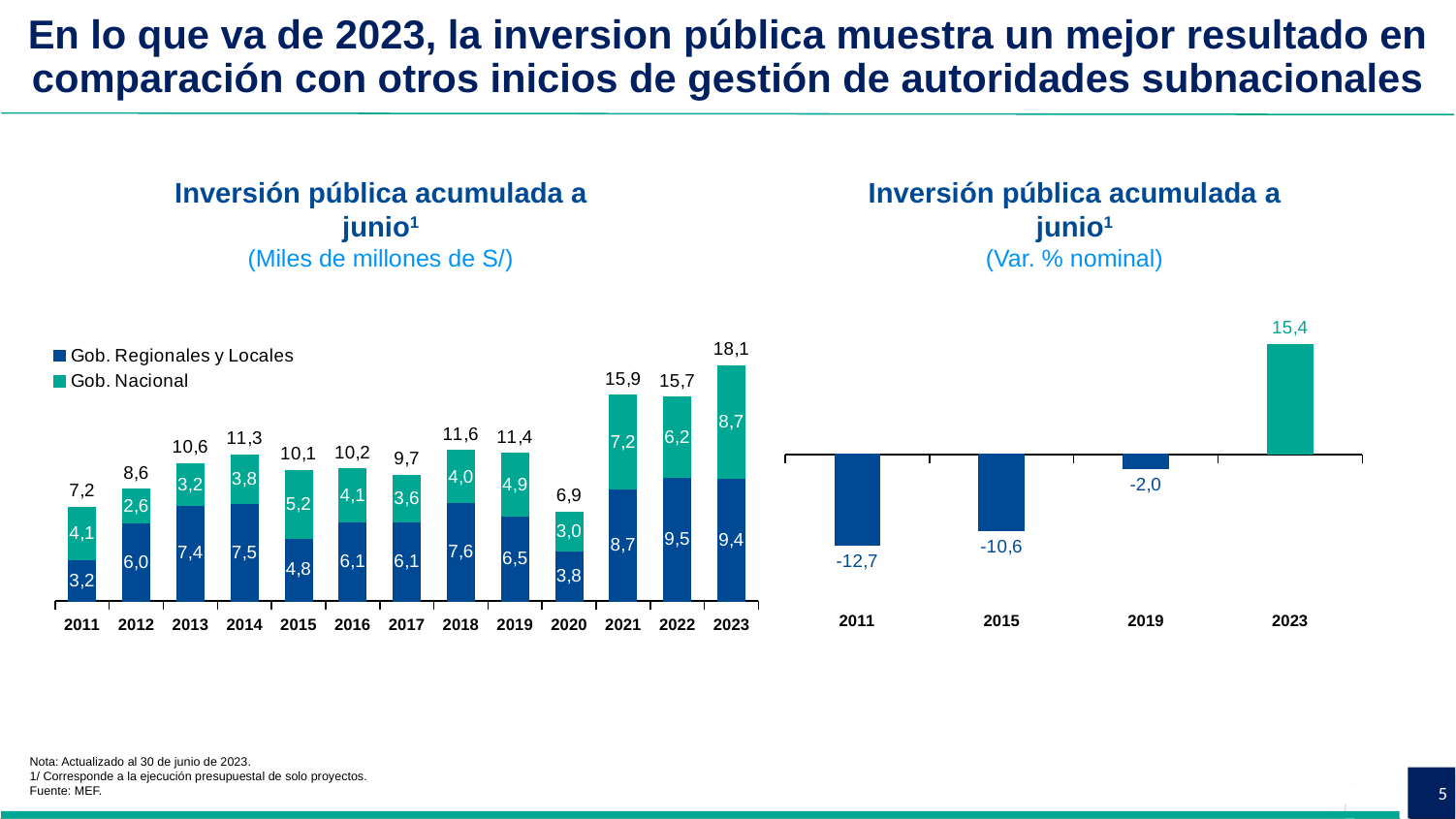
In the left chart (Miles de millones de S/), what is the value for Gob. Regionales y Locales in 2022? 9,5 In the left chart (Miles de millones de S/), what is the value for Gob. Nacional in 2015? 5,2 In the left chart (Miles de millones de S/), what is the total public investment for 2023? 18,1 In the left chart (Miles de millones de S/), how many series does the legend list? 2 In the right chart (Var. % nominal), is the value for 2015 larger or smaller than the value for 2019? smaller In the right chart (Var. % nominal), which year has the highest value? 2023 In the left chart (Miles de millones de S/), which year has the lowest total? 2020 In the left chart (Miles de millones de S/), how many years are shown on the x axis? 13 In the left chart (Miles de millones de S/), what is the difference between the totals for 2023 and 2022? 2,4 What kind of chart is the right chart (Var. % nominal)? bar chart In the left chart (Miles de millones de S/), which year has the highest total? 2023 In the right chart (Var. % nominal), what is the value for 2011? -12,7